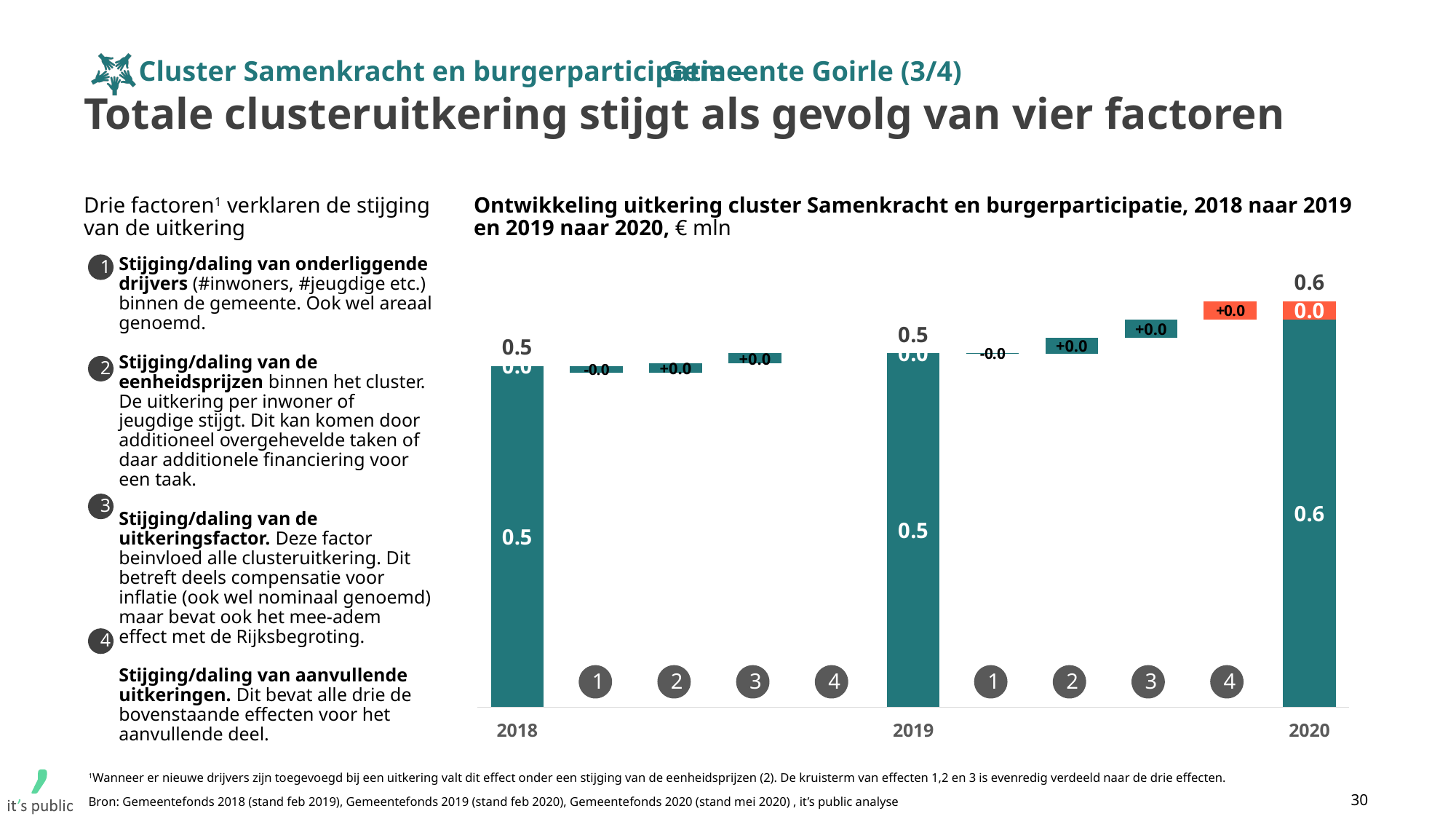
How many numbered factor steps are shown between 2019 and 2020? 4 What is the value of the large teal segment of the 2020 bar? 0.6 What is the difference between the total for 2020 and the total for 2018? 0.1 What is the total value shown above the bar for 2020? 0.6 What is the total value shown above the bar for 2018? 0.5 How many year totals (2018, 2019, 2020) are shown as full bars in the chart? 3 In what unit are the values in the chart expressed, according to the chart title? € mln Which year has the highest total value? 2020 What kind of chart is shown on the slide? Bar chart (waterfall) Do the year totals rise or fall from 2018 to 2020? rise What is the value of the large teal segment of the 2019 bar? 0.5 Is the total for 2020 larger or smaller than the total for 2019? larger